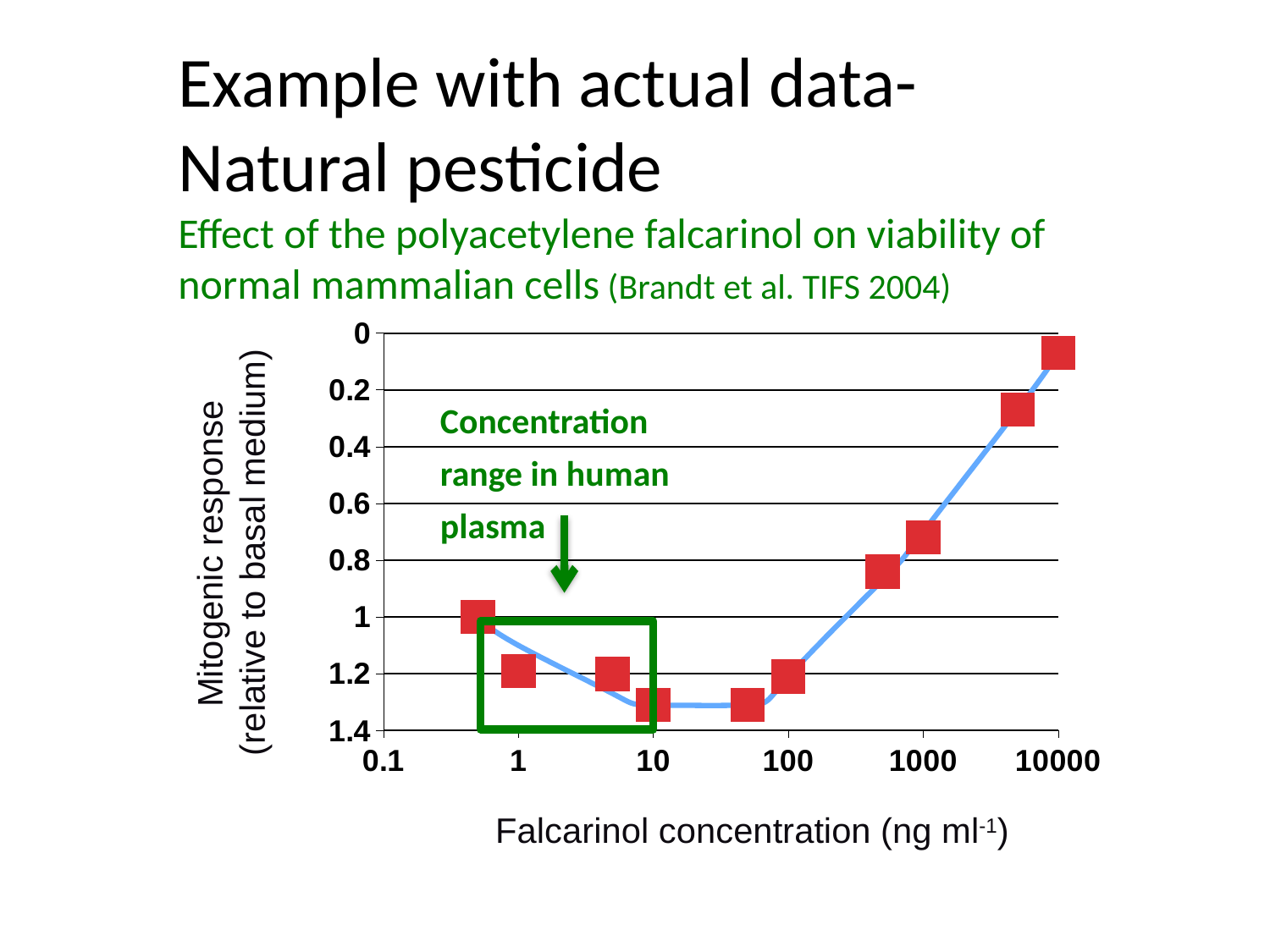
Is the mitogenic response value at a falcarinol concentration of 50 greater or less than 1.2? greater Between concentrations of 100 and 10000 on the x axis, do the plotted mitogenic response values numerically increase or decrease? decrease Which has the numerically larger mitogenic response value: the point at a concentration of 1000 or the point at 10000? 1000 Is the mitogenic response value at a falcarinol concentration of 10000 greater or less than 0.2? less What is the lowest tick label shown on the x axis? 0.1 What is the title of the x axis? Falcarinol concentration (ng ml-1) What text is written in green inside the plot area above the green box? Concentration range in human plasma How many data points are plotted on the chart? 10 Is the mitogenic response value at a falcarinol concentration of 1000 greater or less than 0.6? greater What kind of chart is shown on the slide? Line chart with markers At which falcarinol concentration is the mitogenic response value numerically lowest? 10000